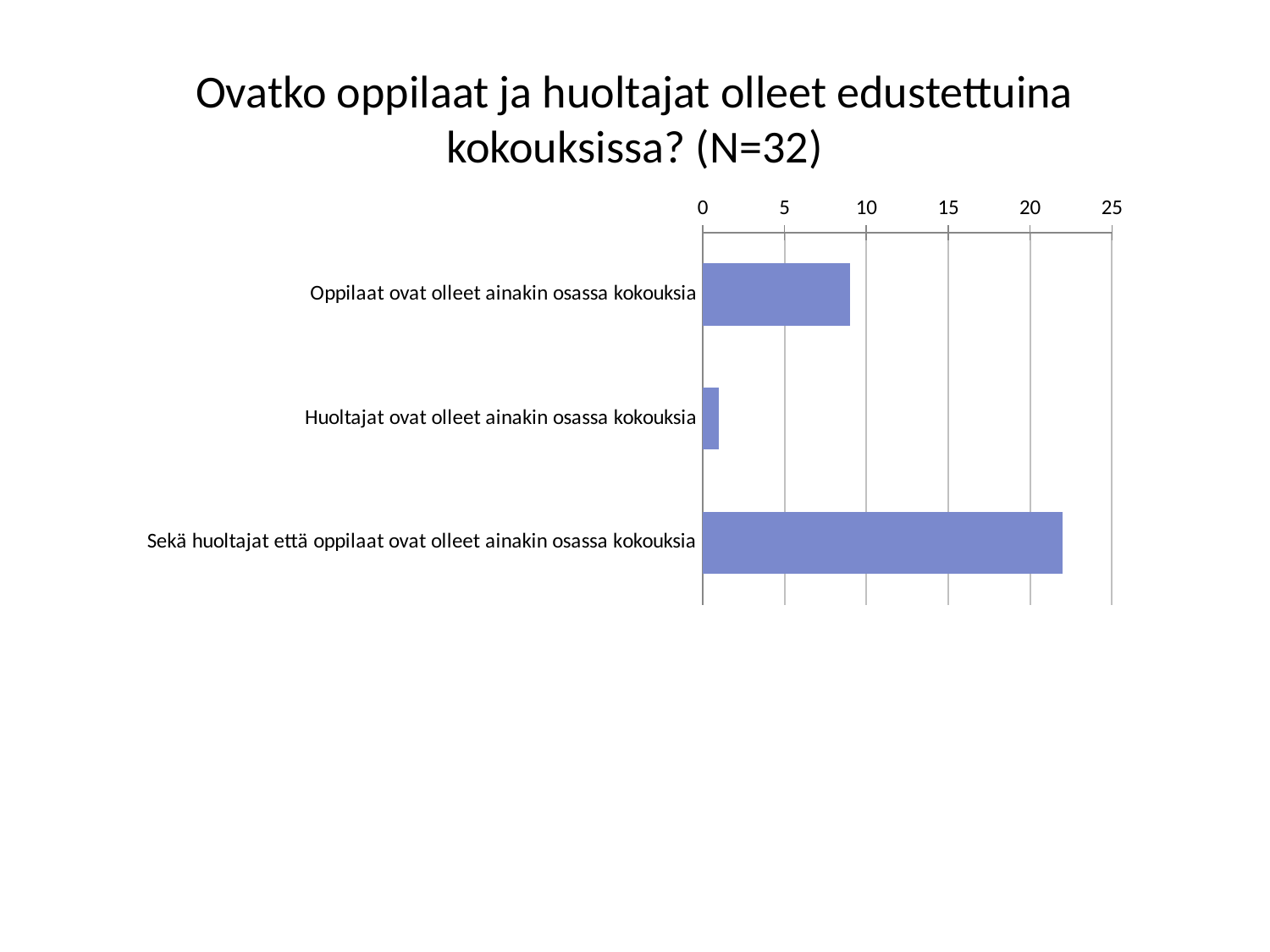
Which category has the lowest value? Huoltajat ovat olleet ainakin osassa kokouksia Which category has the highest value? Sekä huoltajat että oppilaat ovat olleet ainakin osassa kokouksia What is the title of the slide? Ovatko oppilaat ja huoltajat olleet edustettuina kokouksissa? (N=32) Which is larger: the value for "Oppilaat ovat olleet ainakin osassa kokouksia" or the value for "Huoltajat ovat olleet ainakin osassa kokouksia"? Oppilaat ovat olleet ainakin osassa kokouksia What kind of chart is shown on the slide? bar chart Is the value for "Sekä huoltajat että oppilaat ovat olleet ainakin osassa kokouksia" greater or less than 20? greater How many categories are shown in the chart? 3 Is the value for "Oppilaat ovat olleet ainakin osassa kokouksia" greater or less than 5? greater Which is larger: the value for "Oppilaat ovat olleet ainakin osassa kokouksia" or the value for "Sekä huoltajat että oppilaat ovat olleet ainakin osassa kokouksia"? Sekä huoltajat että oppilaat ovat olleet ainakin osassa kokouksia Is the value for "Sekä huoltajat että oppilaat ovat olleet ainakin osassa kokouksia" greater or less than 25? less What is the maximum value shown on the chart's value axis? 25